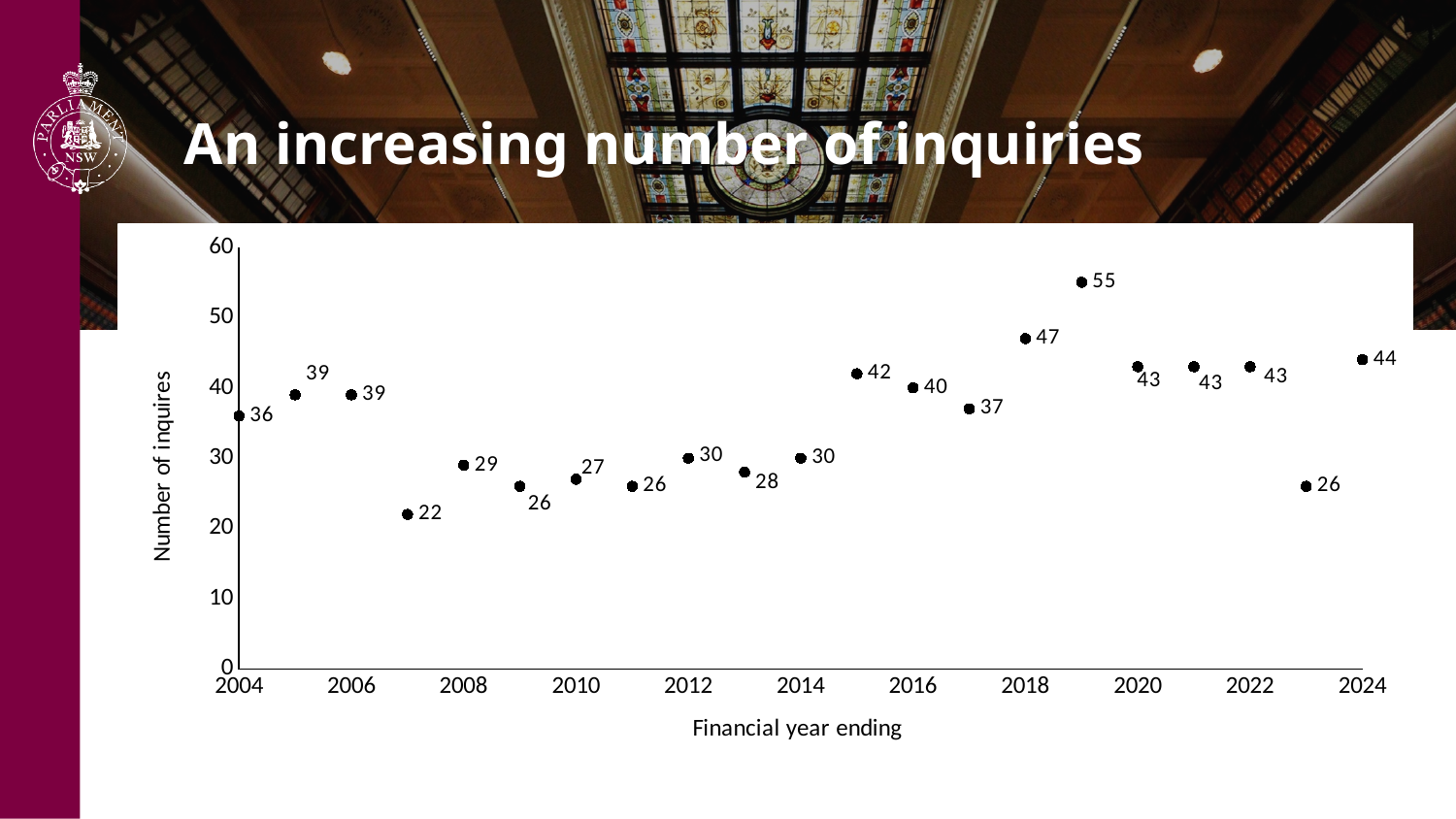
Is the value for 2023 greater or less than 30? less What is the number of inquiries for the financial year ending 2024? 44 Which year had more inquiries, 2015 or 2017? 2015 What is the label of the x axis? Financial year ending Which financial year has the lowest number of inquiries? 2007 What is the difference in the number of inquiries between 2019 and 2018? 8 What is the number of inquiries for the financial year ending 2007? 22 What kind of chart is shown on the slide? Scatter plot What is the number of inquiries for the financial year ending 2019? 55 What is the title of the slide above the chart? An increasing number of inquiries How many data points are plotted on the chart? 21 Which financial year has the highest number of inquiries? 2019